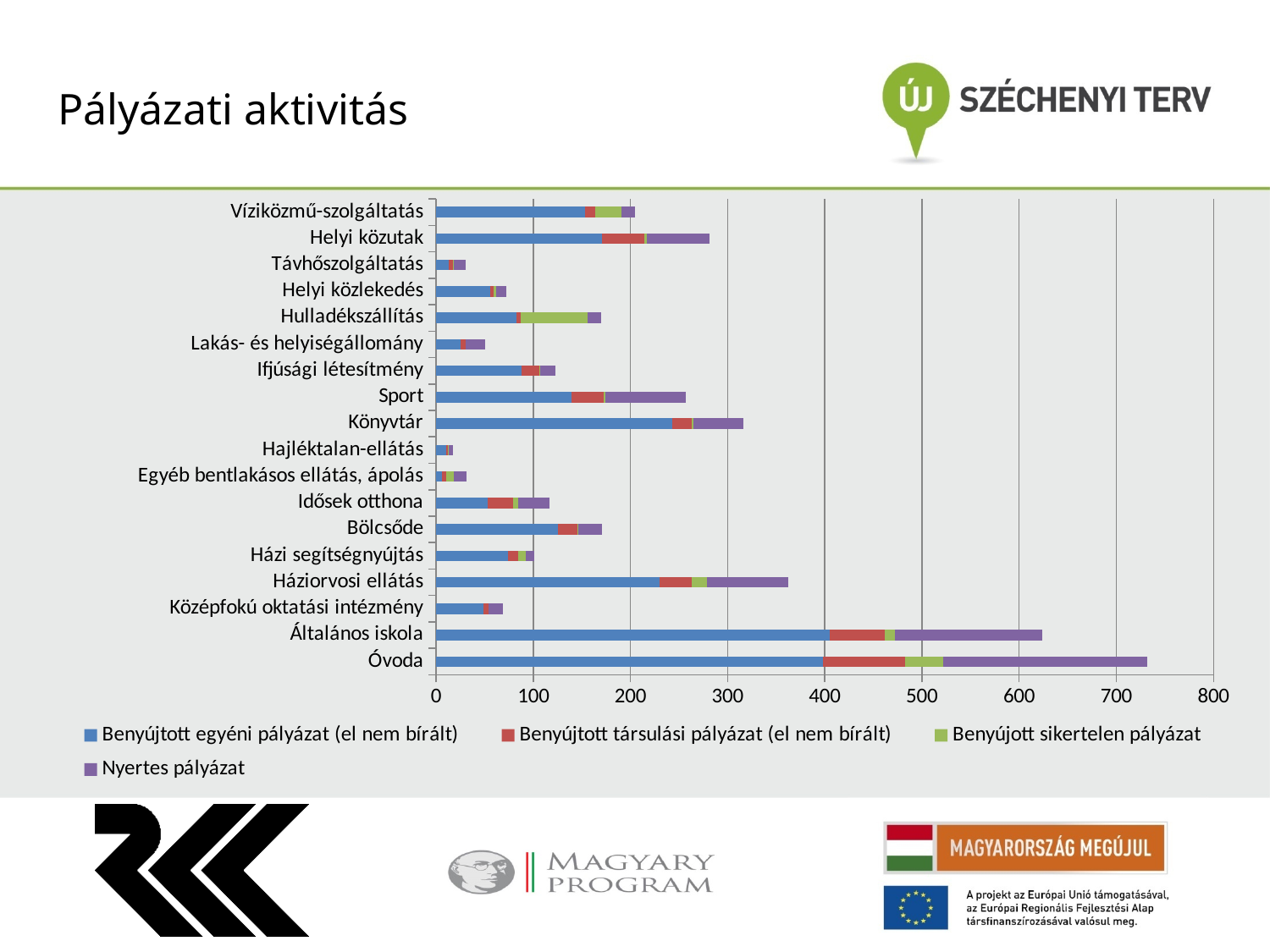
What kind of chart is shown on the slide? Stacked bar chart Is the total bar length for Óvoda greater or less than 600? greater Which category has the longest total bar in the chart? Óvoda Which has the longer total bar, Sport or Könyvtár? Könyvtár Which category has the shortest total bar in the chart? Hajléktalan-ellátás How many categories are listed on the vertical axis of the chart? 18 Is the total bar length for Háziorvosi ellátás greater or less than 300? greater Which has the longer total bar, Óvoda or Általános iskola? Óvoda What is the title of the slide containing the chart? Pályázati aktivitás How many series does the chart's legend list? 4 Is the total bar length for Általános iskola greater or less than 500? greater